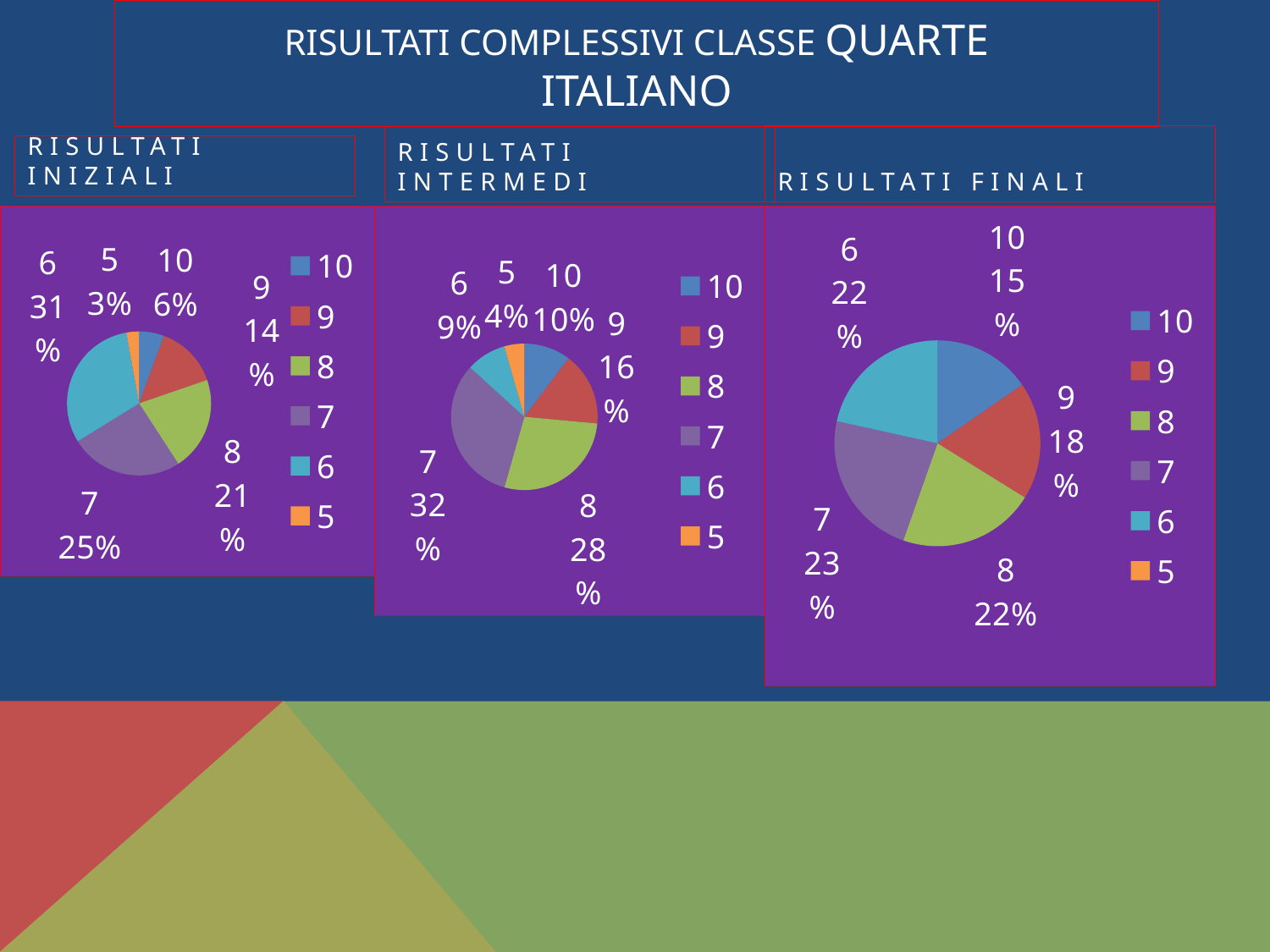
In the RISULTATI INIZIALI chart, what is the difference in percentage points between the slices for grade 7 and grade 8? 4 In the RISULTATI INIZIALI chart, which grade has the smallest slice? 5 In the RISULTATI FINALI chart, what share of the pie is labelled for grade 10? 15% In the RISULTATI INTERMEDI chart, which grade has the largest slice? 7 In the RISULTATI INTERMEDI chart, what share of the pie is labelled for grade 7? 32% What kind of chart is used for RISULTATI INTERMEDI? Pie chart In the RISULTATI FINALI chart, which slice is larger, grade 7 or grade 9? 7 In the RISULTATI INTERMEDI chart, which slice is larger, grade 9 or grade 6? 9 How many entries does the legend of the RISULTATI INIZIALI chart list? 6 How many charts are shown on the slide? 3 In the RISULTATI FINALI chart, what is the difference in percentage points between the slices for grade 9 and grade 10? 3 In the RISULTATI INIZIALI chart, what share of the pie is labelled for grade 6? 31%